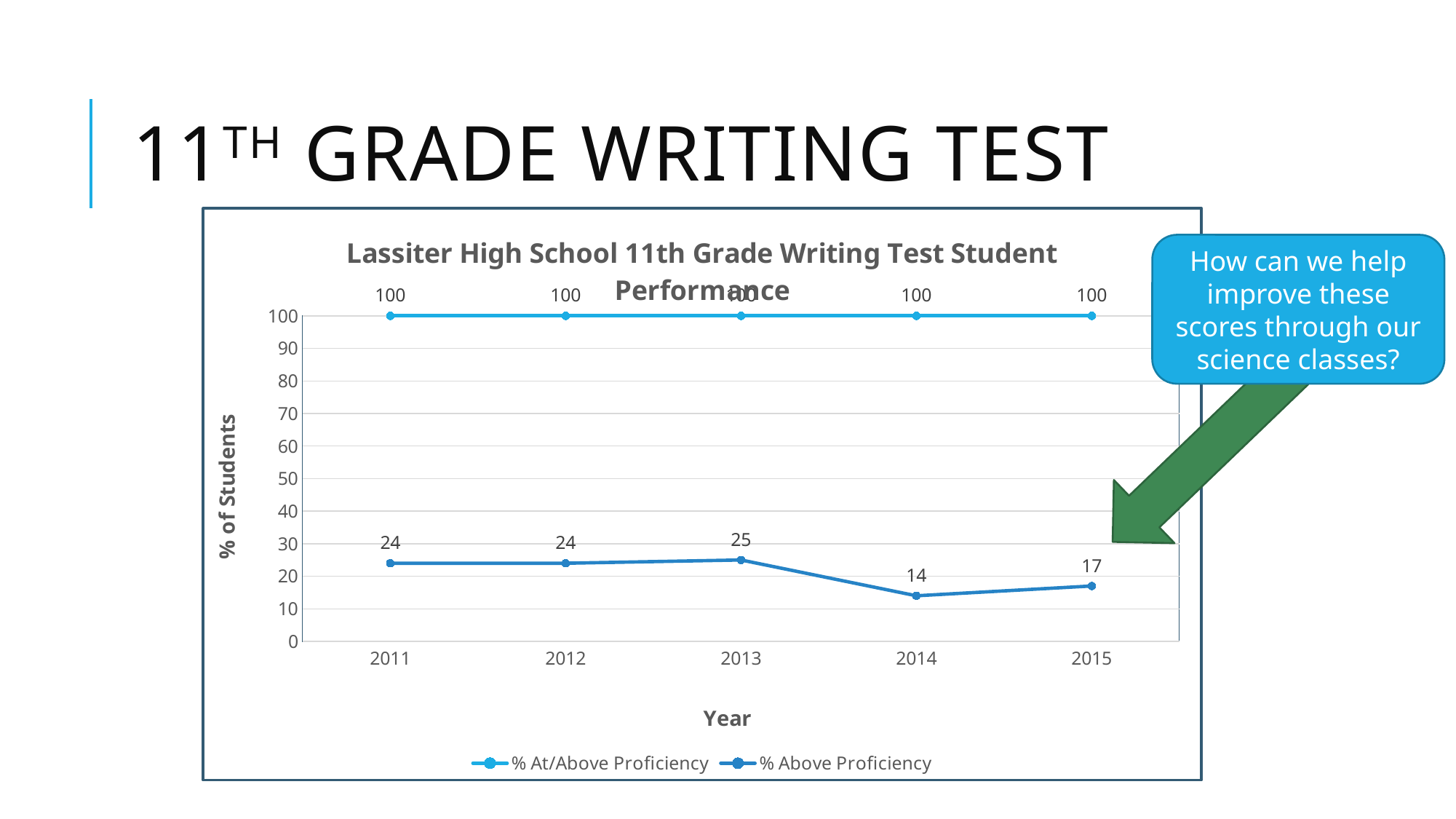
In which year is the % Above Proficiency value highest? 2013 What is the label of the y axis? % of Students What kind of chart is shown? Line chart Which is larger, the % Above Proficiency value for 2011 or for 2015? 2011 What is the % At/Above Proficiency value for 2012? 100 Does the % Above Proficiency series rise or fall from 2013 to 2014? Fall How many years are shown on the x axis? 5 How many series does the legend list? 2 What is the % Above Proficiency value for 2013? 25 What is the difference between the % Above Proficiency values for 2013 and 2014? 11 What is the % Above Proficiency value for 2014? 14 In which year is the % Above Proficiency value lowest? 2014